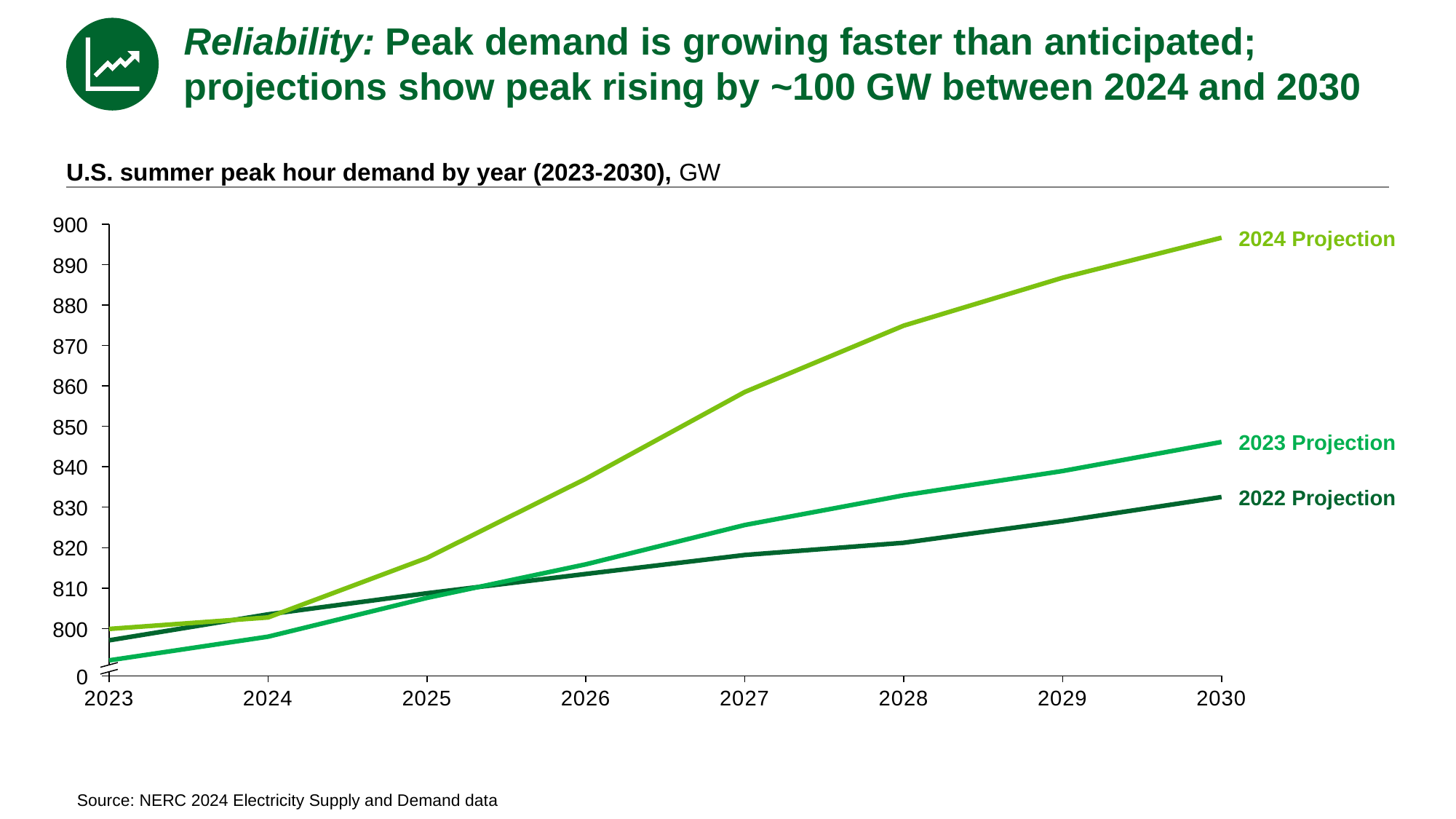
Which projection has the lowest value in 2023? 2023 Projection Does the 2024 Projection rise or fall from 2023 to 2030? Rise Is the value of the 2024 Projection in 2027 greater or less than 850? greater Which projection has the highest value in 2030? 2024 Projection Is the value of the 2023 Projection in 2024 greater or less than 800? less Which projection has the lowest value in 2030? 2022 Projection How many years are shown along the x axis of the chart? 8 In 2024, which is larger: the 2022 Projection or the 2023 Projection? 2022 Projection What unit is the chart's data measured in, according to the chart title? GW What kind of chart is shown on the slide? Line chart Is the value of the 2024 Projection in 2030 greater or less than 890? greater How many series (projections) are plotted on the chart? 3